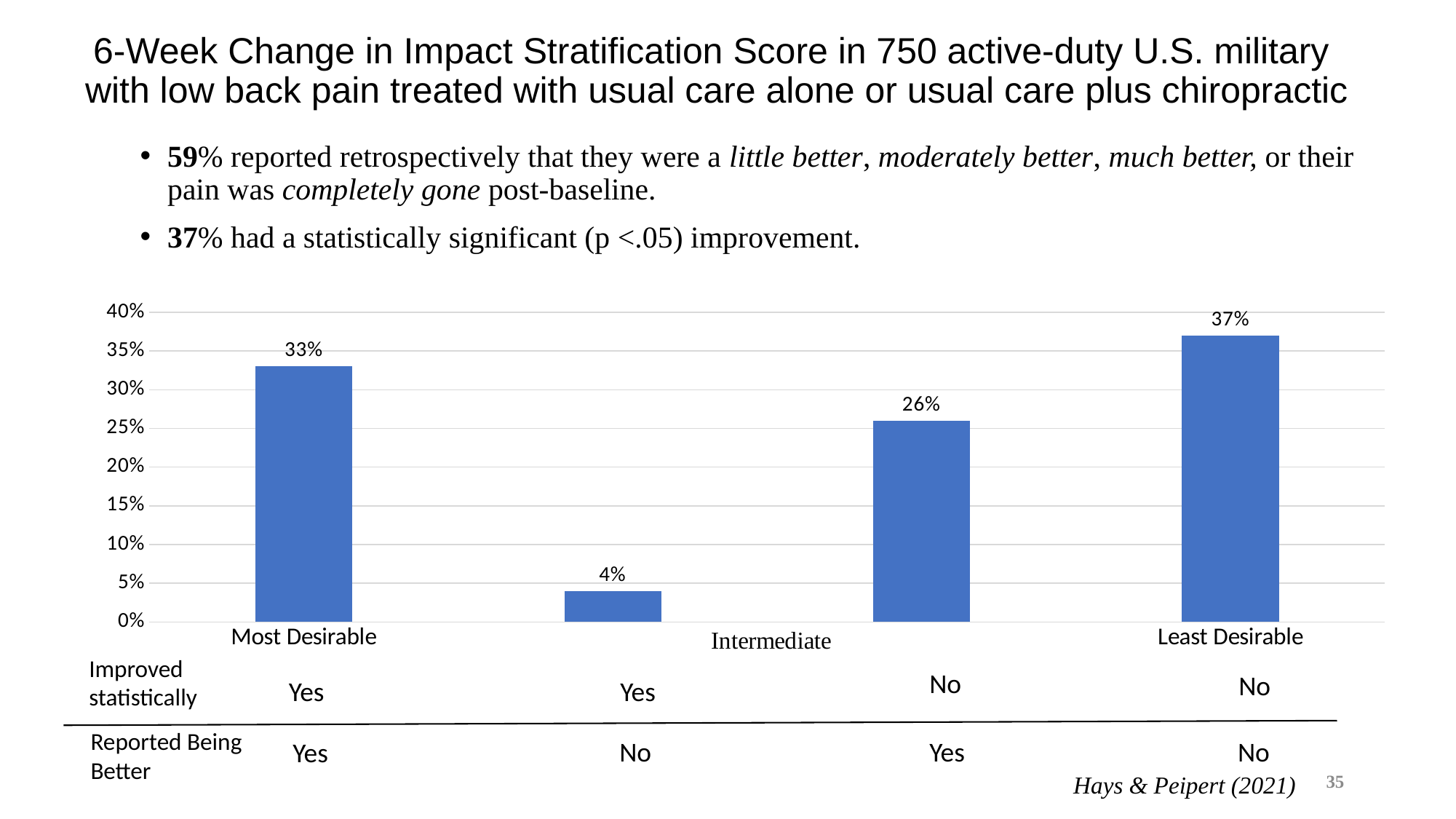
What is the value of the Least Desirable bar? 37% What is the difference between the Least Desirable and Most Desirable bars? 4% What type of chart is shown on the slide? Bar chart What is the difference between the two Intermediate bars? 22% What is the value of the Intermediate bar for those who improved statistically but did not report being better? 4% Which is larger, the Most Desirable bar or the 26% Intermediate bar? Most Desirable What is the highest value shown on the vertical axis? 40% Which bar has the lowest value? The Intermediate bar for improved statistically Yes, reported being better No (4%) What is the value of the Intermediate bar for those who reported being better but did not improve statistically? 26% What is the value of the Most Desirable bar? 33% How many bars are plotted in the chart? 4 Which bar has the highest value? Least Desirable